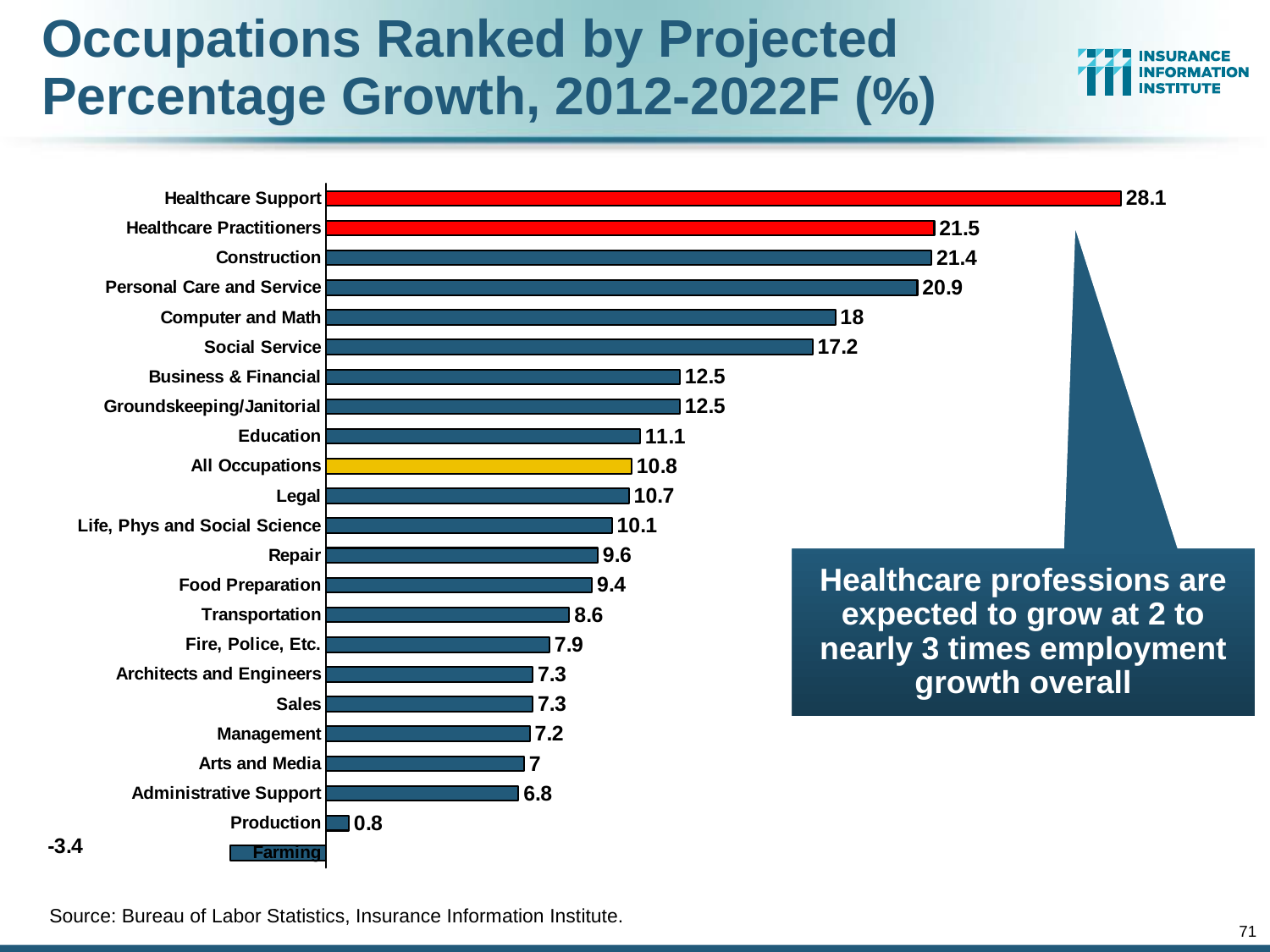
What is the projected percentage growth for Farming? -3.4 What is the projected percentage growth for Computer and Math? 18 What is the projected percentage growth for All Occupations? 10.8 Which bar in the chart is coloured yellow? All Occupations What is the difference between the projected growth for Healthcare Practitioners and Construction? 0.1 What is the projected percentage growth for Healthcare Support? 28.1 Which occupation has the lowest projected percentage growth? Farming How many occupation categories are shown in the chart? 23 What type of chart is shown on the slide? Bar chart What is the difference between the projected growth for Healthcare Support and All Occupations? 17.3 Which has a higher projected growth, Construction or Personal Care and Service? Construction Which occupation has the highest projected percentage growth? Healthcare Support